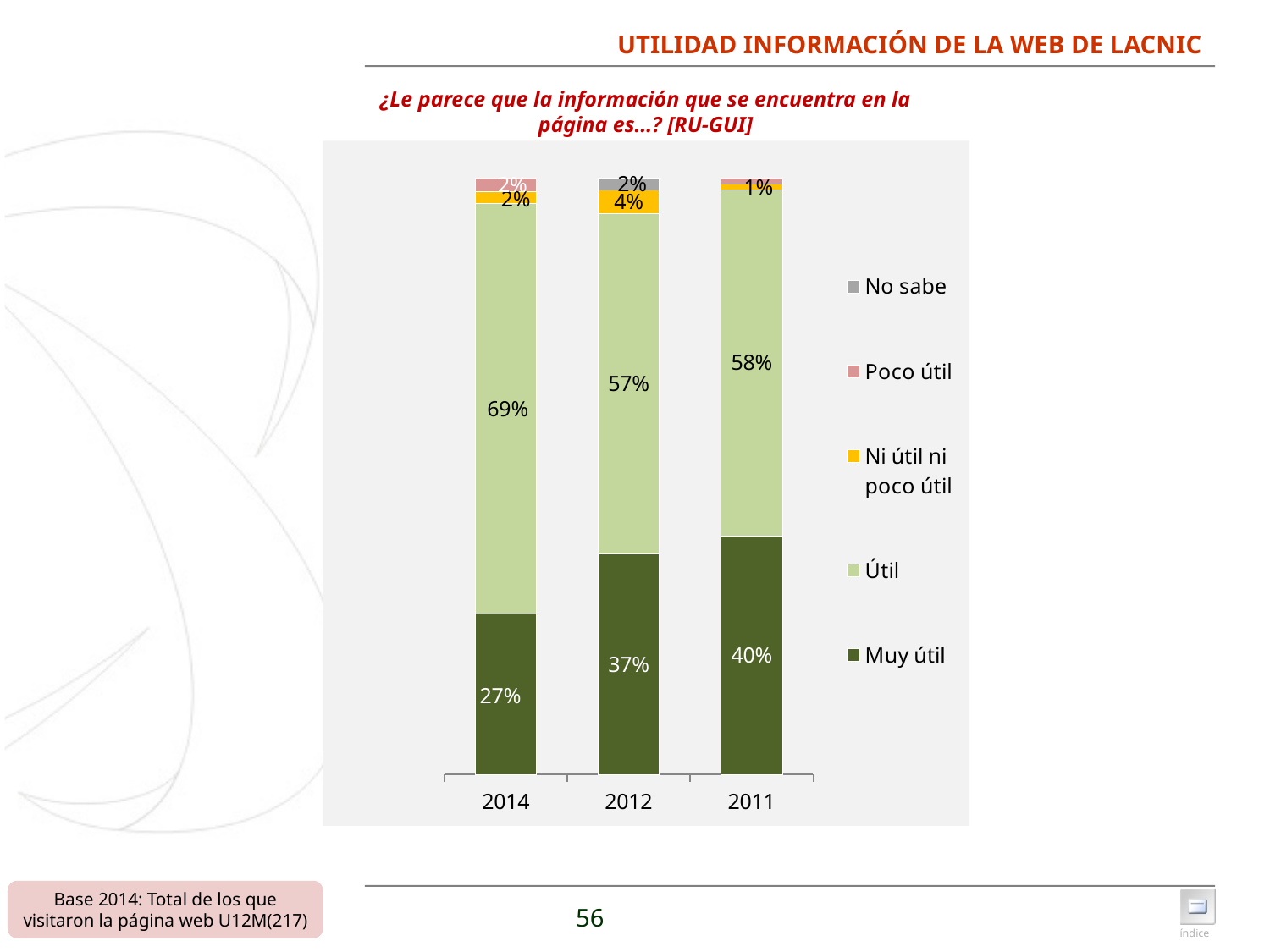
Which year has the larger Útil value, 2012 or 2011? 2011 In which year is the Útil share highest? 2014 What is the value for Útil in 2012? 57% What is the value for Muy útil in 2014? 27% What is the difference between the Muy útil values for 2011 and 2014? 13 percentage points What is the value for Ni útil ni poco útil in 2012? 4% In which year is the Muy útil share lowest? 2014 Does the Muy útil value rise or fall moving left to right across the x axis from 2014 to 2011? Rises How many years are shown on the x axis? 3 What is the value for Muy útil in 2011? 40% How many series does the legend list? 5 What kind of chart is shown? Stacked bar chart